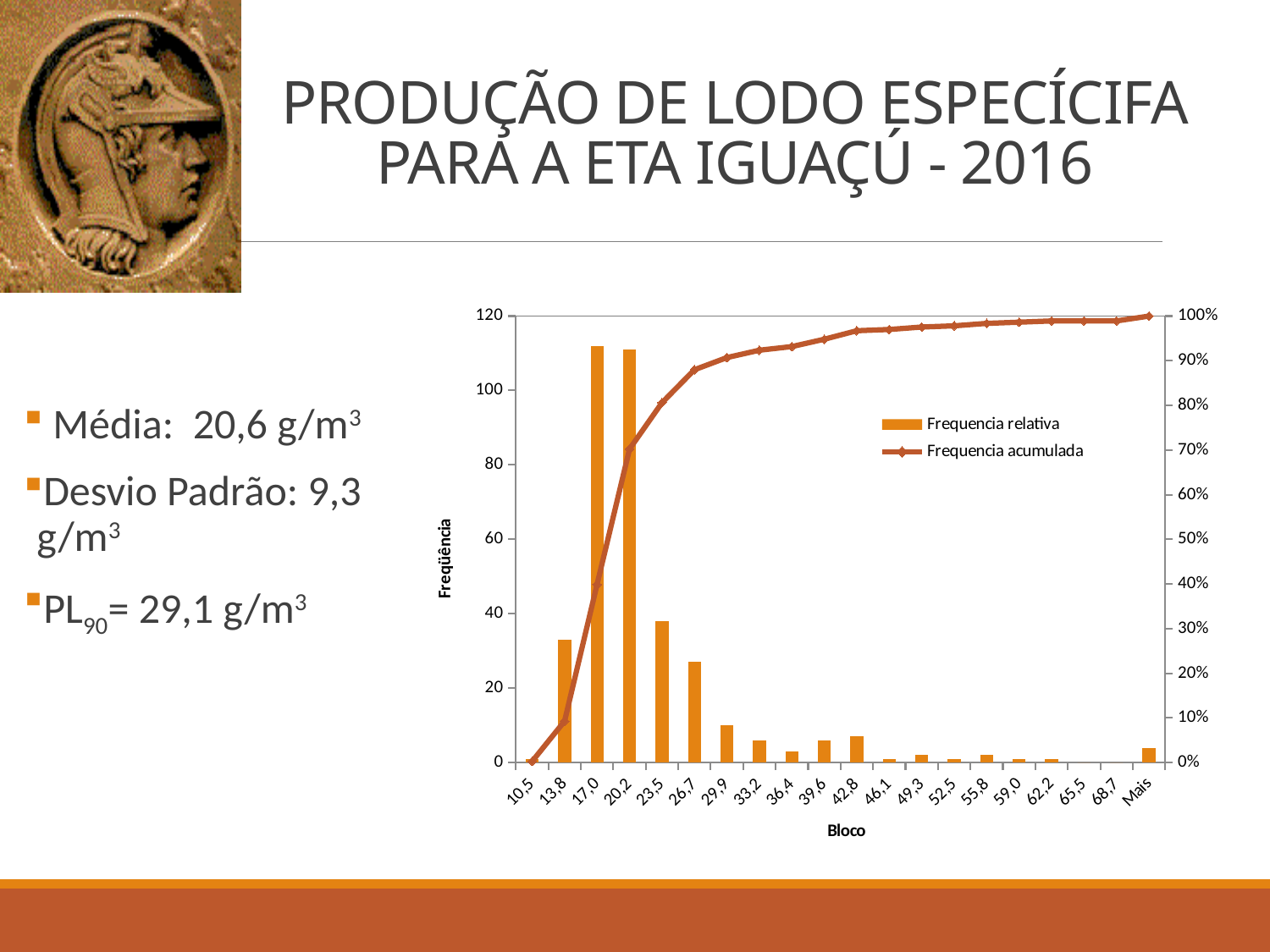
Is the Frequencia relativa bar for bloco 13,8 greater or less than 40? less Which bloco has the larger Frequencia relativa bar, 23,5 or 26,7? 23,5 Which bloco has the larger Frequencia relativa bar, 29,9 or 33,2? 29,9 How many series does the chart legend list? 2 What kind of chart is shown on the slide? A combined bar and line chart What are the two series named in the chart legend? Frequencia relativa and Frequencia acumulada Does the Frequencia acumulada line rise or fall as the bloco values increase along the x axis? rise How many categories are shown on the x axis (Bloco) of the chart? 20 Is the Frequencia acumulada value at bloco 33,2 greater or less than 90%? greater Is the Frequencia relativa bar for bloco 26,7 greater or less than 20? greater